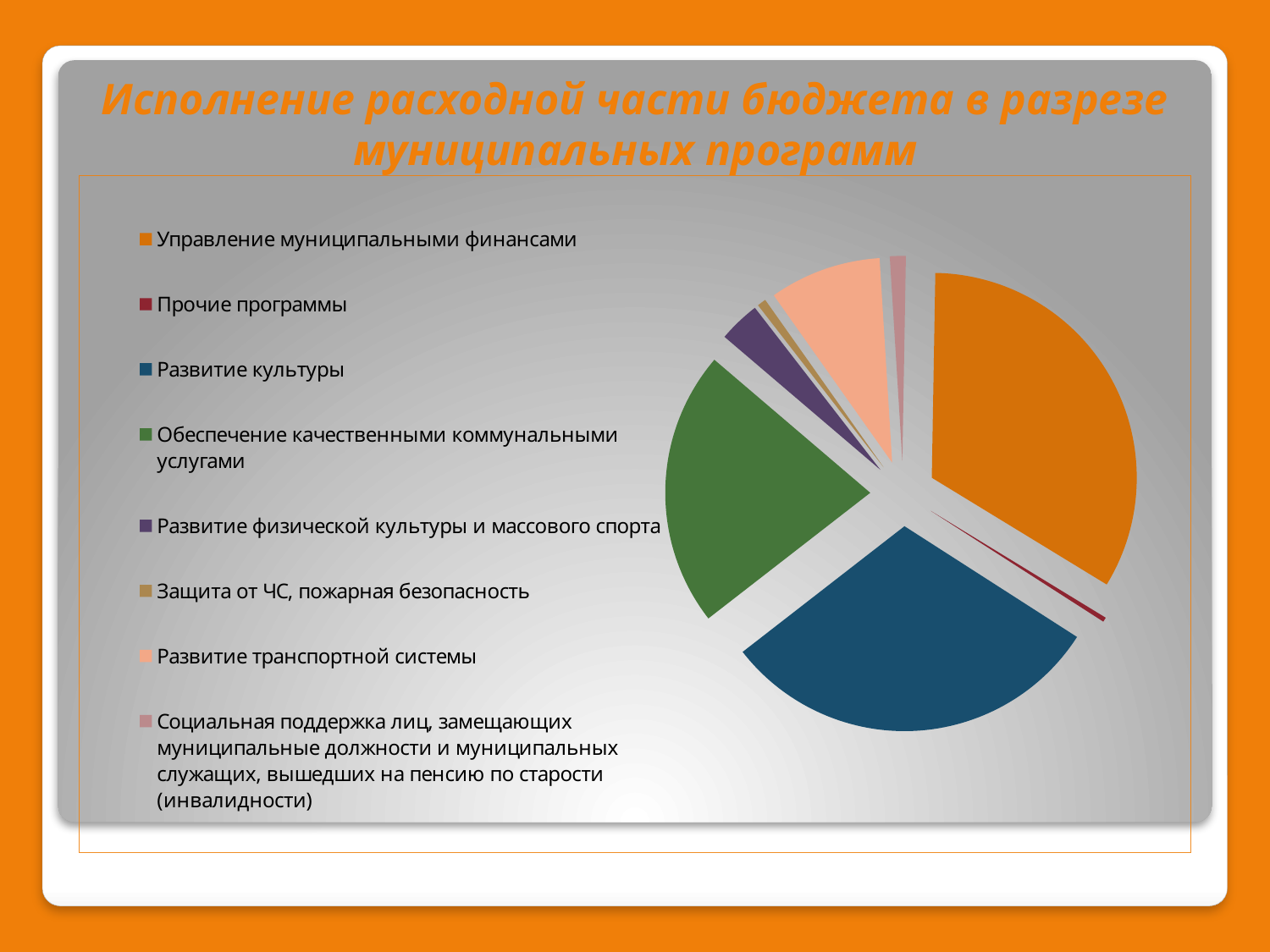
Which category has the largest slice of the pie chart? Управление муниципальными финансами Which slice is larger: Управление муниципальными финансами or Развитие культуры? Управление муниципальными финансами What colour is the slice for Развитие культуры in the pie chart? blue Which slice is larger: Управление муниципальными финансами or Обеспечение качественными коммунальными услугами? Управление муниципальными финансами Which slice is larger: Развитие культуры or Прочие программы? Развитие культуры What is the title of the slide containing the pie chart? Исполнение расходной части бюджета в разрезе муниципальных программ What kind of chart is shown on the slide? pie chart How many categories does the legend of the pie chart list? 8